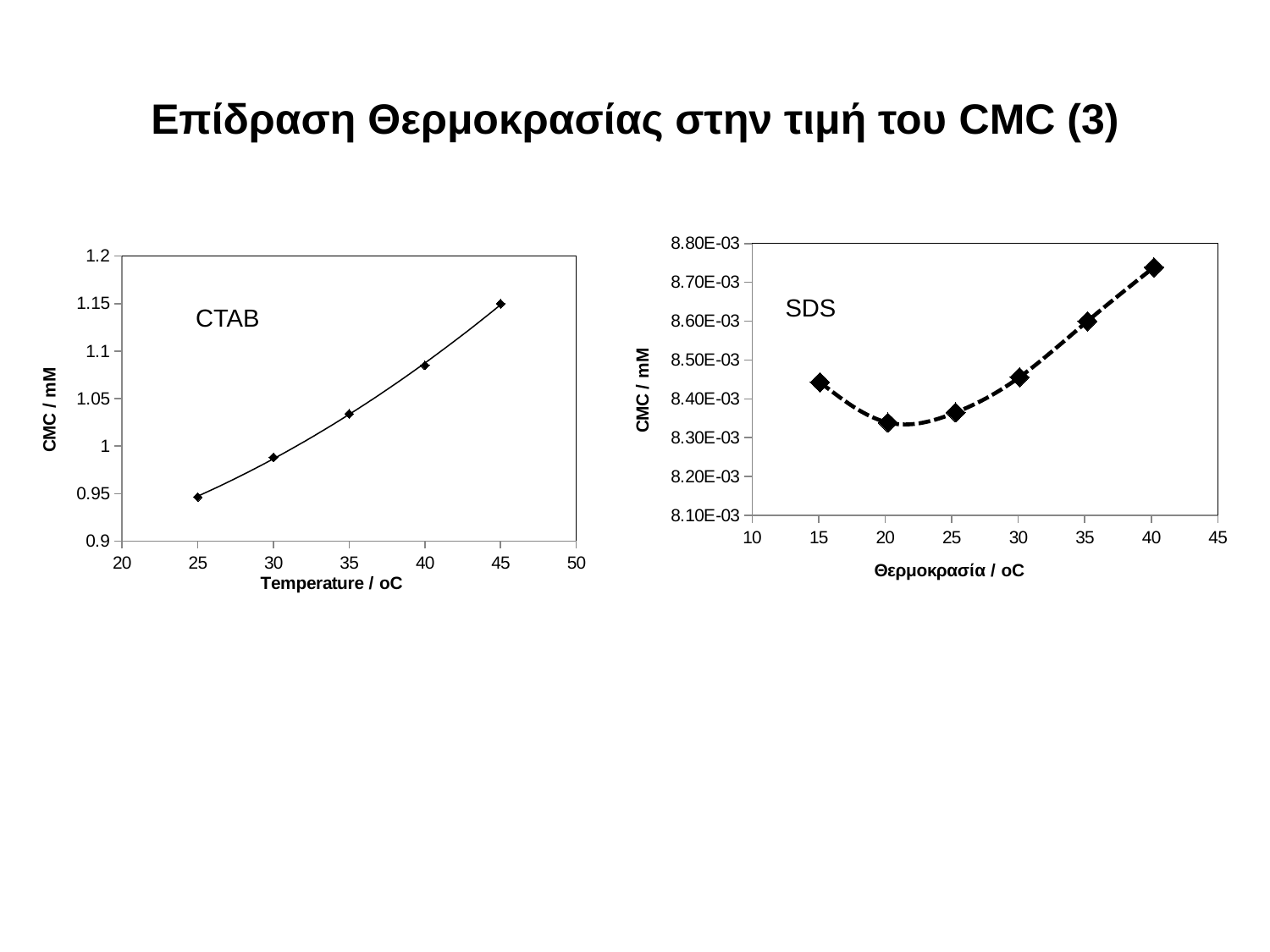
What is the x-axis title of the CTAB chart? Temperature / oC On the SDS chart, is the CMC value at 40 °C greater or less than 8.70E-03? greater On the CTAB chart, does the CMC rise or fall as temperature increases? rise On the CTAB chart, at which temperature is the CMC highest? 45 On the CTAB chart, is the CMC value at 40 °C greater or less than 1.05? greater On the SDS chart, which has the larger CMC value: 15 °C or 25 °C? 15 °C What kind of chart is the CTAB chart on the left? line chart How many data points are plotted on the SDS chart? 6 How many data points are plotted on the CTAB chart? 5